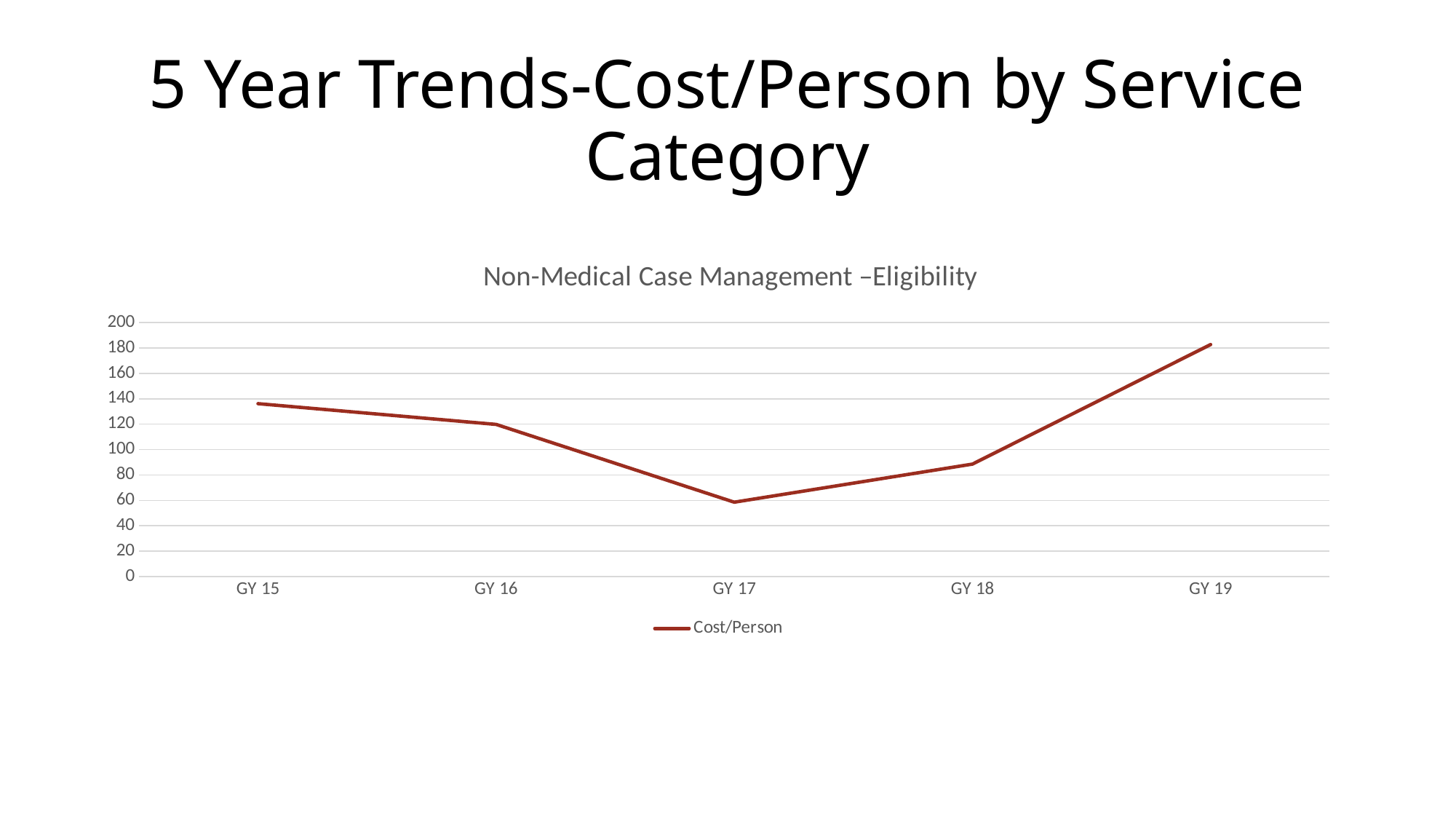
What is the name of the series shown in the legend? Cost/Person Is the Cost/Person for GY 19 greater or less than 160? greater How many grant years are plotted on the x axis? 5 What is the title of the chart? Non-Medical Case Management –Eligibility Is the Cost/Person for GY 17 greater or less than 80? less Does the Cost/Person rise or fall from GY 15 to GY 17? fall Which grant year has the highest Cost/Person? GY 19 How many series does the legend list? 1 Is the Cost/Person for GY 15 greater or less than 120? greater Which has a higher Cost/Person, GY 16 or GY 18? GY 16 What kind of chart is shown on the slide? line chart Which grant year has the lowest Cost/Person? GY 17